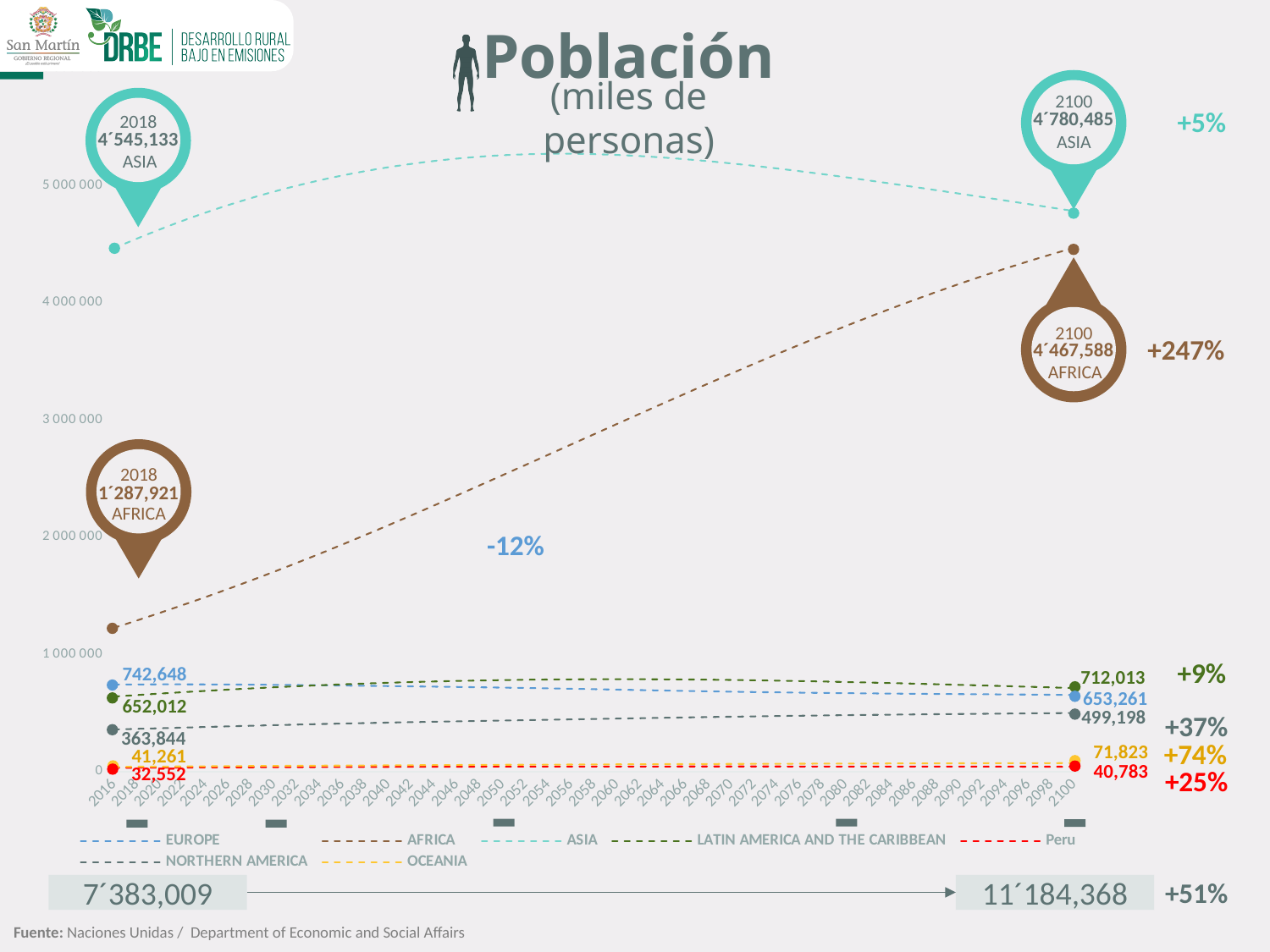
Which region has the highest population in 2100? Asia What is the population value shown for Asia in 2018? 4´545,133 In 2100, which is larger, the population of Asia or of Africa? Asia Does the population of Europe rise or fall from 2018 to 2100? fall What is the population value shown for Africa in 2100? 4´467,588 What kind of chart is shown on the slide? line chart What is the population value shown for Europe in 2018? 742,648 What is the population value shown for Peru in 2100? 40,783 Which series has the lowest population in 2018? Peru How many series does the legend list? 7 What is the difference between Africa's population in 2100 and in 2018? 3´179,667 What percentage change is shown for Africa between 2018 and 2100? +247%